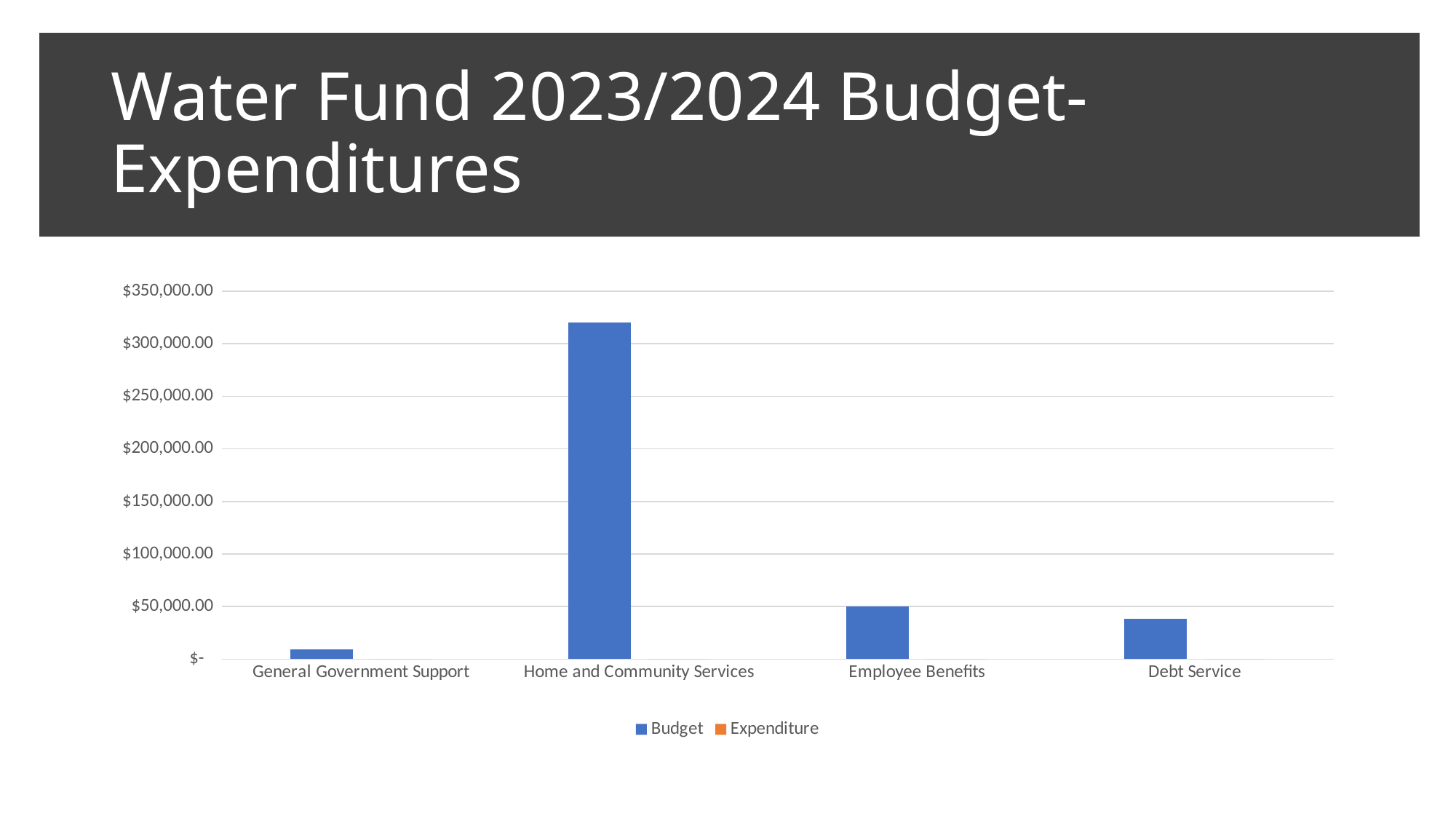
Which category has the lowest Budget value? General Government Support How many series does the chart's legend list? 2 What kind of chart is shown on the slide? Bar chart What colour represents the Budget series in the chart? Blue Which has a larger Budget value, Home and Community Services or Employee Benefits? Home and Community Services How many categories are shown on the x axis of the chart? 4 Is the Budget value for General Government Support greater or less than $50,000.00? less Which category has the highest Budget value? Home and Community Services What are the two series named in the chart's legend? Budget and Expenditure Is the Budget value for Debt Service greater or less than $50,000.00? less Which has a larger Budget value, Employee Benefits or Debt Service? Employee Benefits Is the Budget value for Home and Community Services greater or less than $300,000.00? greater